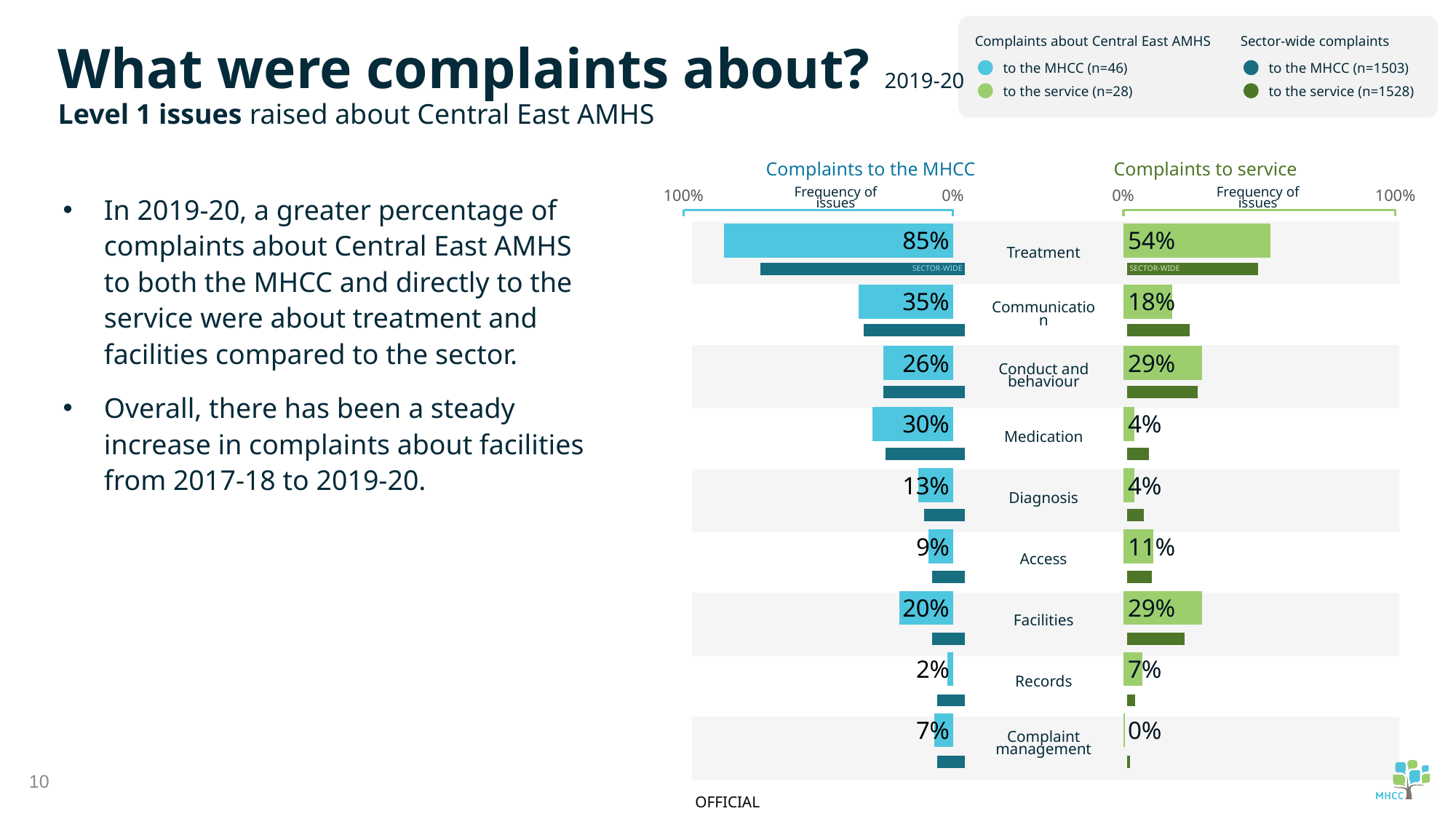
For Medication, which is larger: the Complaints to the MHCC percentage or the Complaints to service percentage? Complaints to the MHCC In the Complaints to the MHCC chart, what is the difference between the Treatment and Communication percentages? 50 percentage points In the Complaints to service chart, what percentage of complaints were about Records? 7% In the Complaints to service chart, what percentage of complaints were about Facilities? 29% In the Complaints to service chart, which issue has the highest percentage? Treatment In the Complaints to the MHCC chart, which issue has the highest percentage? Treatment In the Complaints to the MHCC chart, what percentage of complaints were about Treatment? 85% How many issue categories are shown in the Complaints to the MHCC chart? 9 What type of chart is the Complaints to service chart? Bar chart In the Complaints to service chart, what is the difference between the Treatment and Conduct and behaviour percentages? 25 percentage points In the Complaints to the MHCC chart, which issue has the lowest percentage? Records In the Complaints to service chart, which issue has the lowest percentage? Complaint management